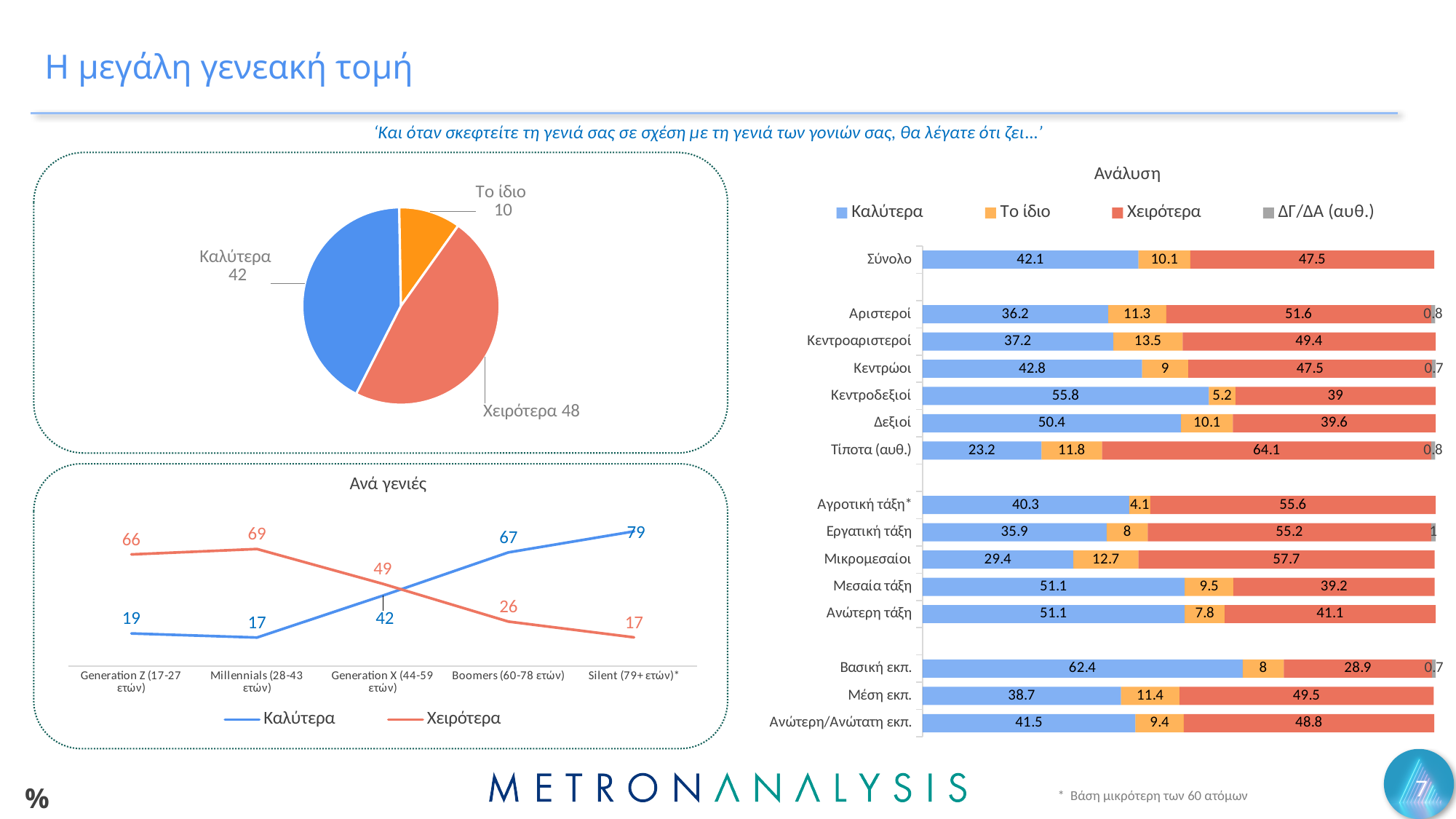
In the 'Ανάλυση' chart, which category has the highest Χειρότερα value? Τίποτα (αυθ.) In the 'Ανά γενιές' line chart, what is the difference between Καλύτερα and Χειρότερα for Boomers (60-78 ετών)? 41 In the 'Ανά γενιές' line chart, what is the Χειρότερα value for Millennials (28-43 ετών)? 69 In the 'Ανάλυση' chart, how many series does the legend list? 4 What kind of chart is the 'Ανάλυση' chart on the right? stacked bar chart In the 'Ανάλυση' chart, which has the larger Καλύτερα value, Κεντροδεξιοί or Δεξιοί? Κεντροδεξιοί In the 'Ανάλυση' chart, what is the Καλύτερα value for Βασική εκπ.? 62.4 In the pie chart on the left, what is the value for Χειρότερα? 48 In the 'Ανά γενιές' line chart, how many generation categories are shown on the x axis? 5 In the pie chart on the left, which category has the largest slice? Χειρότερα In the 'Ανά γενιές' line chart, does the Καλύτερα line generally rise or fall from Generation Z to Silent? rise In the 'Ανά γενιές' line chart, what is the Καλύτερα value for Silent (79+ ετών)*? 79